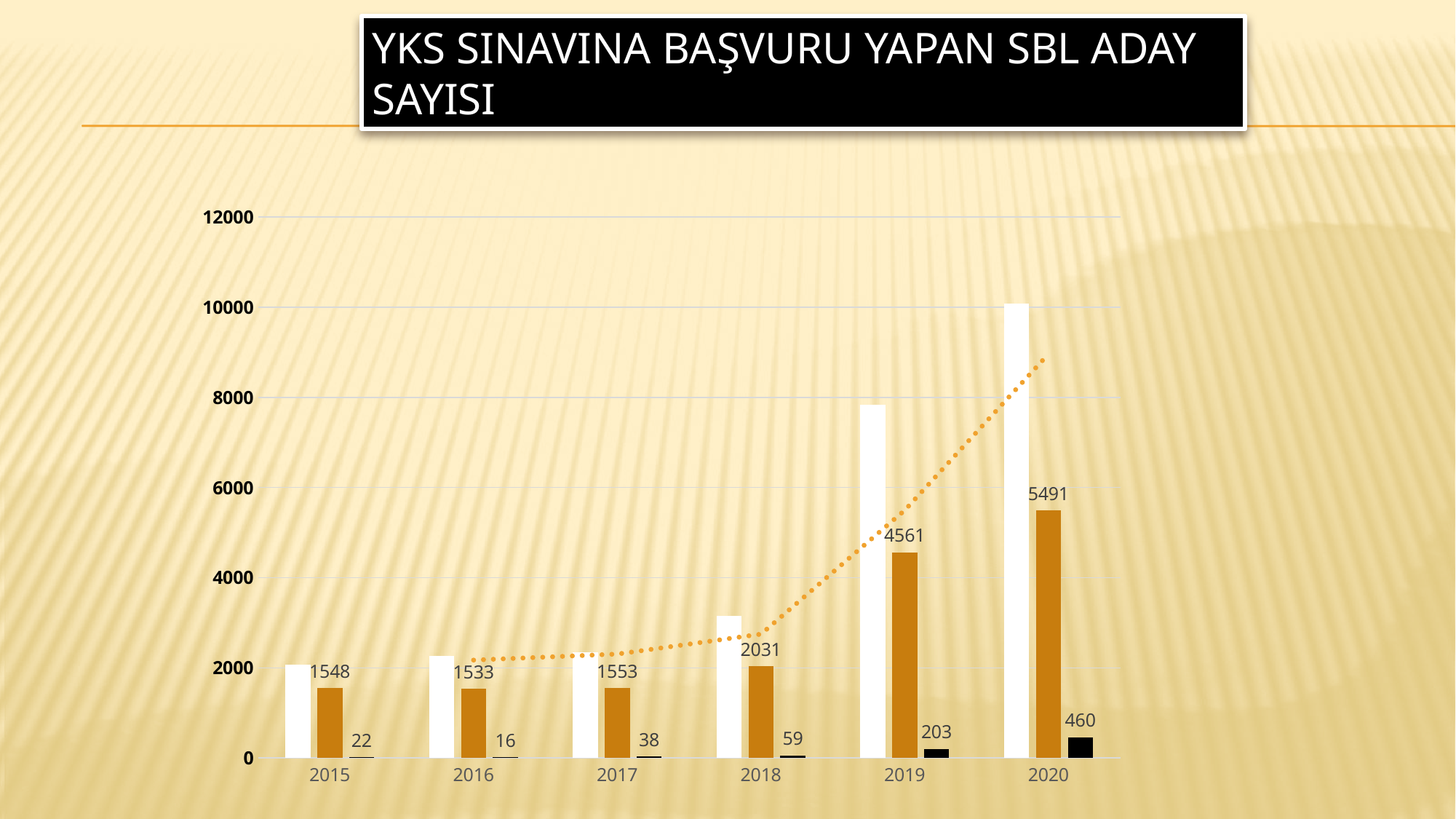
What is the value of the black bar for 2016? 16 What is the value of the orange bar for 2018? 2031 What kind of chart is shown on the slide? bar chart What is the value of the black bar for 2019? 203 How many years are shown on the x axis? 6 What is the difference between the orange bar values for 2020 and 2019? 930 In which year is the black bar lowest? 2016 Which is larger, the orange bar for 2015 or the orange bar for 2016? 2015 What is the difference between the black bar values for 2020 and 2019? 257 What is the value of the orange bar for 2020? 5491 In which year is the orange bar highest? 2020 Is the value of the white bar for 2019 greater or less than 6000? greater